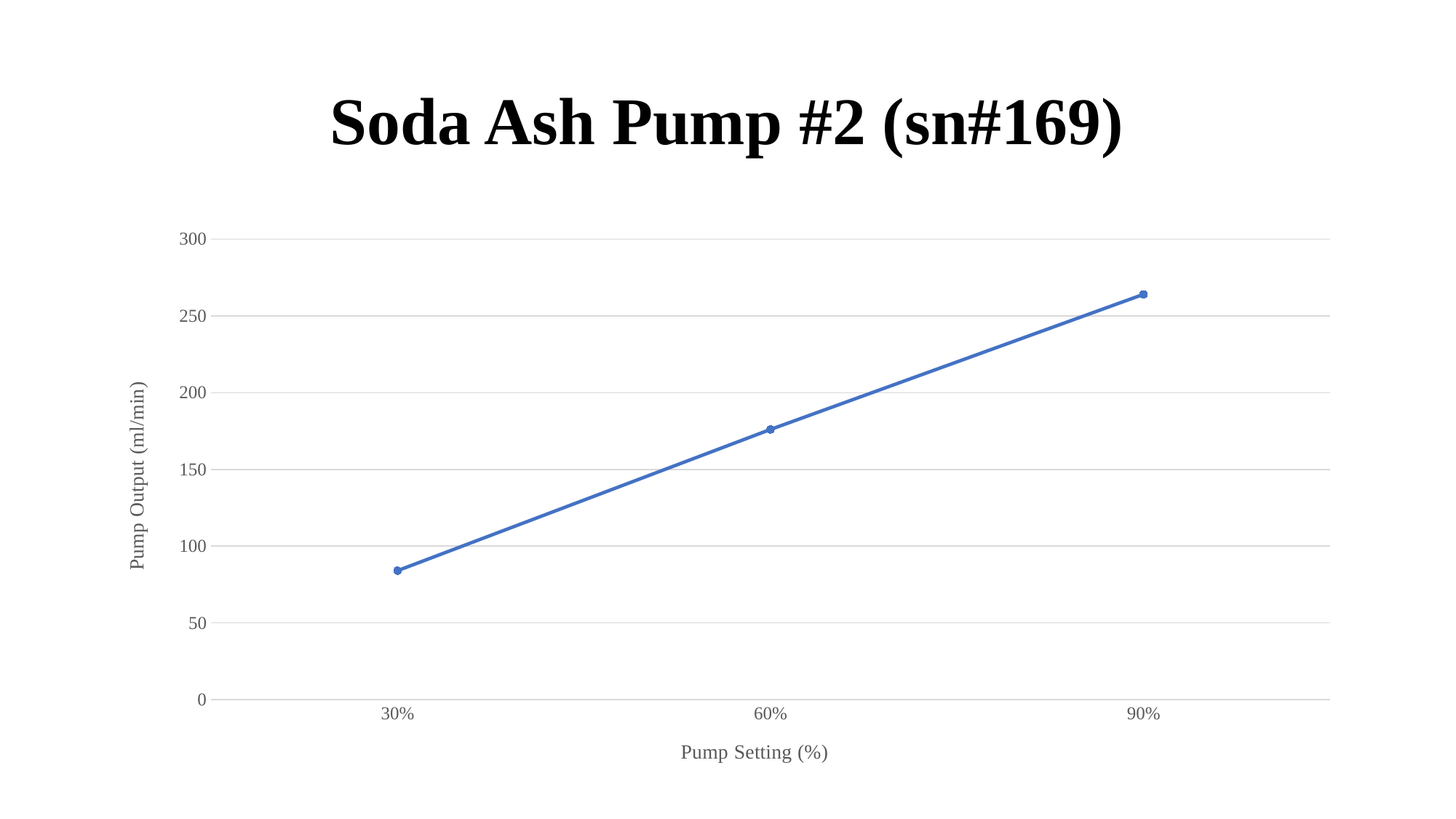
Is the pump output at the 30% setting greater or less than 100? less Is the pump output at the 60% setting greater or less than 150? greater Which has the larger pump output, the 30% setting or the 60% setting? 60% What kind of chart is shown on the slide? line chart Does the pump output rise or fall as the pump setting increases from 30% to 90%? rise What is the label of the y axis? Pump Output (ml/min) What is the title of the chart? Soda Ash Pump #2 (sn#169) Is the pump output at the 90% setting greater or less than 250? greater Which pump setting has the lowest pump output? 30% Which pump setting has the highest pump output? 90% How many data points are plotted on the line? 3